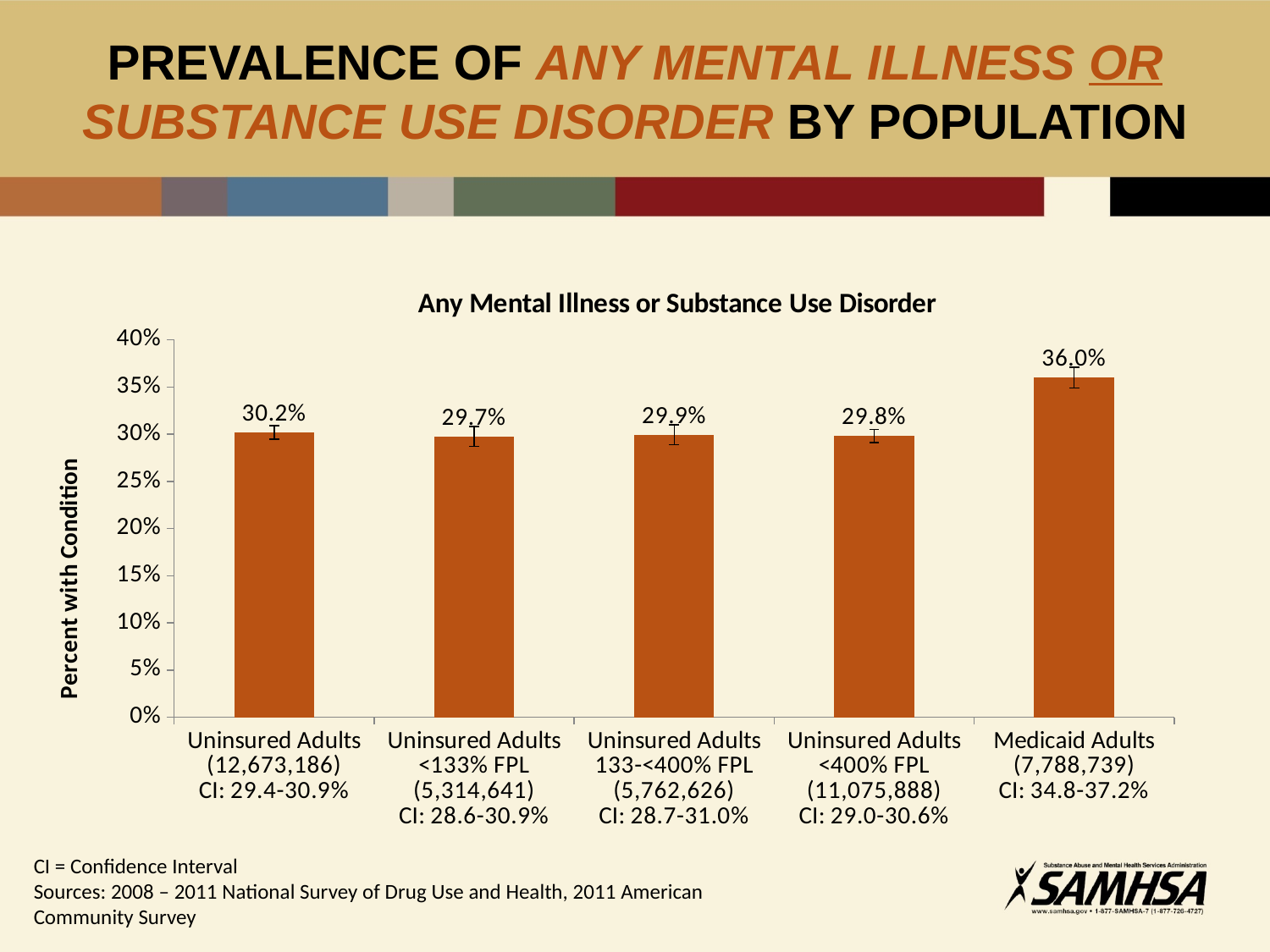
What kind of chart is shown on the slide? bar chart What is the difference between the values for Medicaid Adults and Uninsured Adults <400% FPL? 6.2% Which is larger, the value for Medicaid Adults or the value for Uninsured Adults <133% FPL? Medicaid Adults What is the value for Uninsured Adults 133-<400% FPL? 29.9% What is the value for Uninsured Adults <133% FPL? 29.7% Which category has the highest value? Medicaid Adults Is the value for Medicaid Adults greater or less than 35%? greater What is the value for Medicaid Adults? 36.0% How many categories are shown on the x axis? 5 What is the value for Uninsured Adults (all, 12,673,186)? 30.2% What is the label of the y axis? Percent with Condition What is the title of the chart? Any Mental Illness or Substance Use Disorder